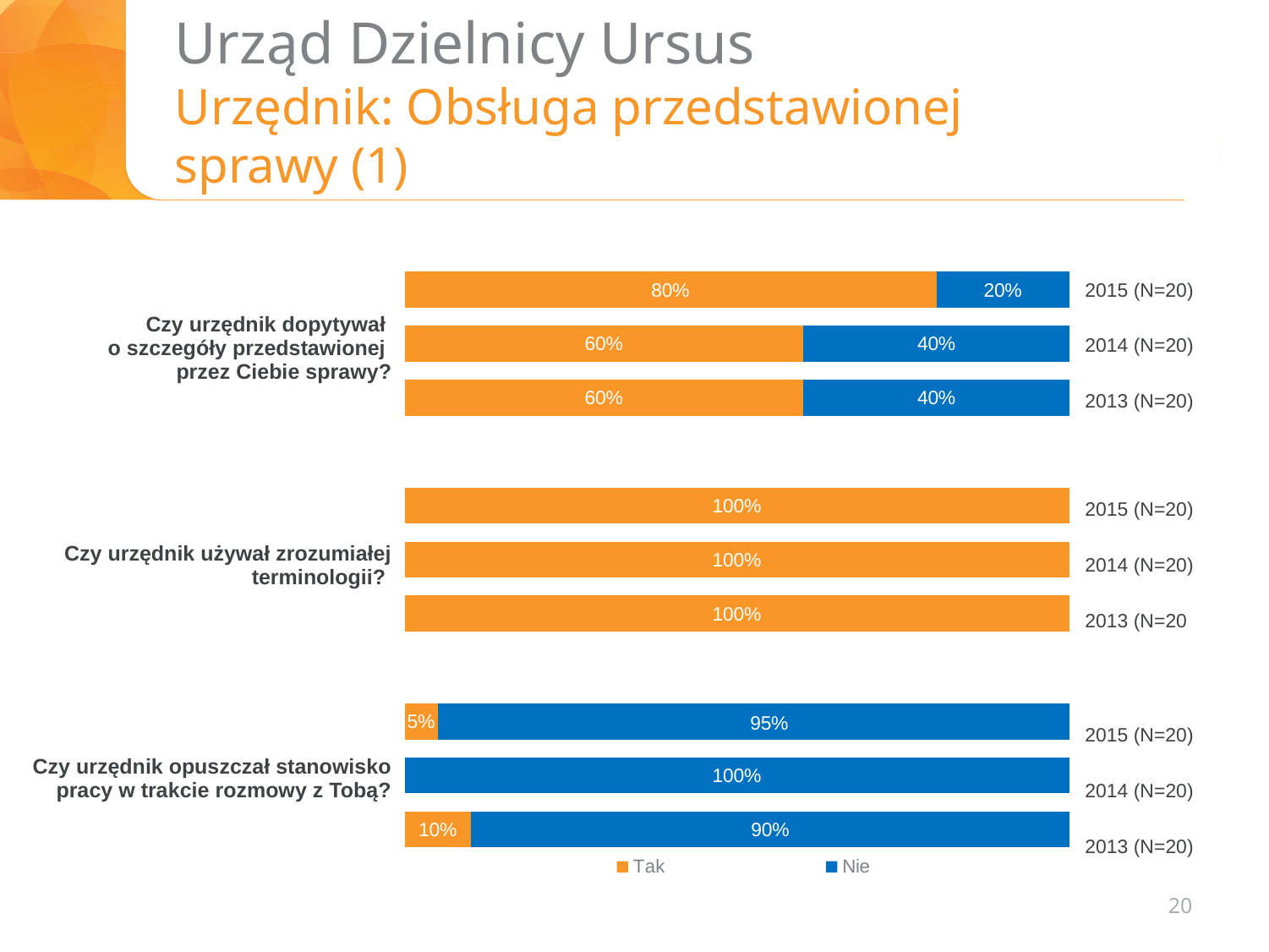
In the chart for "Czy urzędnik używał zrozumiałej terminologii?", what is the "Tak" value for 2014 (N=20)? 100% What kind of chart is shown on the slide? stacked bar chart Which colour represents "Nie" in the legend? blue In the chart for "Czy urzędnik dopytywał o szczegóły przedstawionej przez Ciebie sprawy?", what is the "Nie" value for 2014 (N=20)? 40% In the chart for "Czy urzędnik opuszczał stanowisko pracy w trakcie rozmowy z Tobą?", is the "Nie" value for 2015 larger or smaller than the "Nie" value for 2013? larger In the chart for "Czy urzędnik opuszczał stanowisko pracy w trakcie rozmowy z Tobą?", what is the "Nie" value for 2015 (N=20)? 95% In the chart for "Czy urzędnik dopytywał o szczegóły przedstawionej przez Ciebie sprawy?", what is the "Tak" value for 2015 (N=20)? 80% In the chart for "Czy urzędnik opuszczał stanowisko pracy w trakcie rozmowy z Tobą?", which year has the lowest "Nie" share? 2013 (N=20) In the chart for "Czy urzędnik opuszczał stanowisko pracy w trakcie rozmowy z Tobą?", what is the "Tak" value for 2013 (N=20)? 10% How many series does the legend list? 2 In the chart for "Czy urzędnik dopytywał o szczegóły przedstawionej przez Ciebie sprawy?", which year has the highest "Tak" share? 2015 (N=20) In the chart for "Czy urzędnik dopytywał o szczegóły przedstawionej przez Ciebie sprawy?", what is the difference between the "Tak" values for 2015 and 2014? 20%